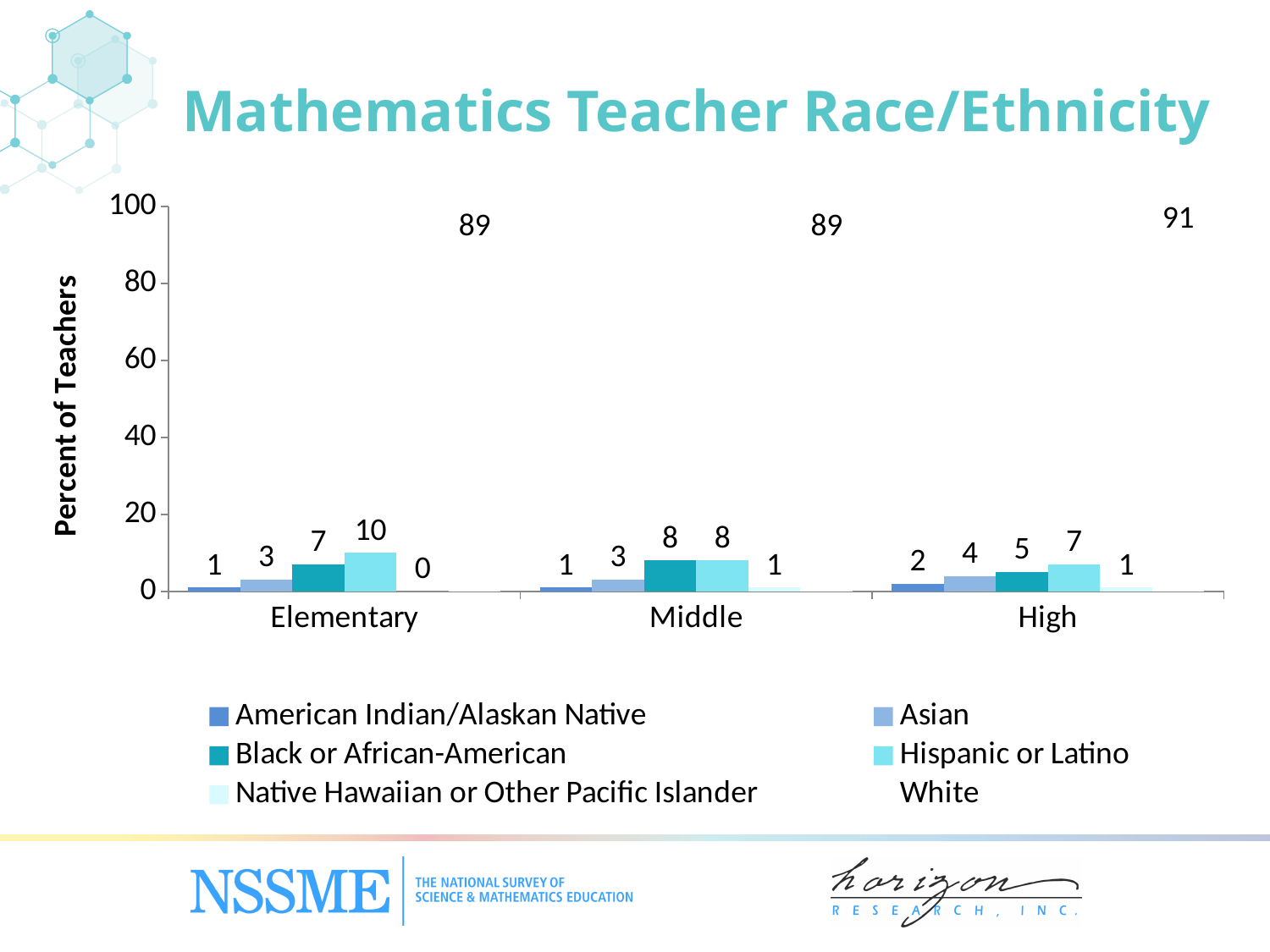
Is the Black or African-American percentage larger for Middle or for High? Middle How many grade-level categories are shown on the x axis? 3 Which grade level has the lowest percentage of Hispanic or Latino mathematics teachers? High What is the label on the vertical axis? Percent of Teachers What percent of high school mathematics teachers are White? 91 What kind of chart is shown on the slide? Bar chart What is the difference between the Hispanic or Latino percentage for Elementary and for High? 3 Which grade level has the highest percentage of White mathematics teachers? High What percent of elementary mathematics teachers are Hispanic or Latino? 10 How many series does the legend list? 6 What is the value for Asian teachers in the High category? 4 What percent of middle school mathematics teachers are Black or African-American? 8